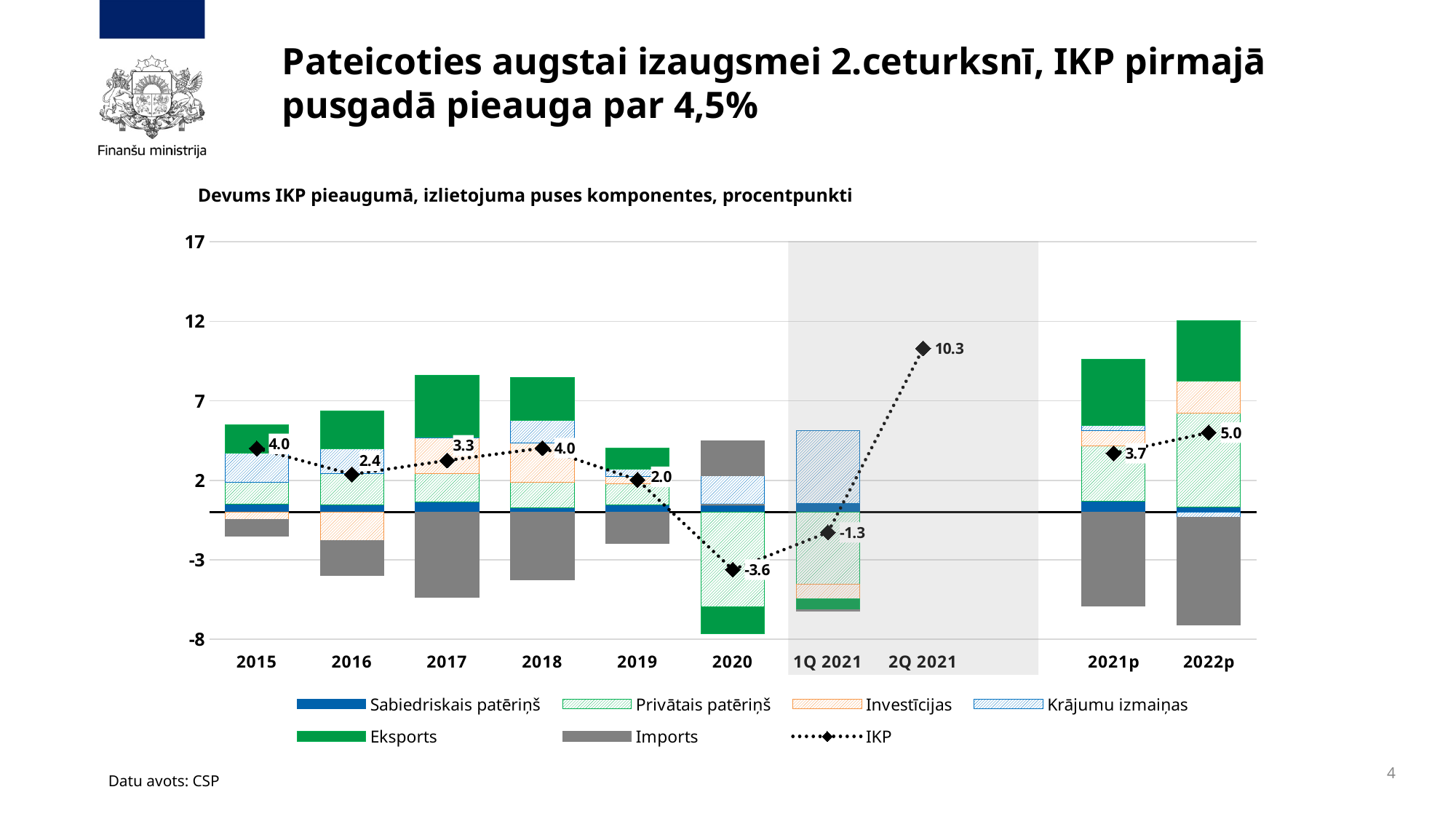
Which category has the lowest IKP value? 2020 What is the IKP value for 2Q 2021? 10.3 Does the IKP value rise or fall from 2019 to 2020? Fall What is the IKP value for 2020? -3.6 What is the difference between the IKP values for 2022p and 2021p? 1.3 What is the IKP value for 2015? 4.0 How many series does the legend list? 7 Which has the larger IKP value, 2016 or 2017? 2017 What kind of chart is shown on the slide? Stacked bar chart with a line How many categories are shown on the x axis? 10 What is the IKP value for 2022p? 5.0 Which category has the highest IKP value? 2Q 2021